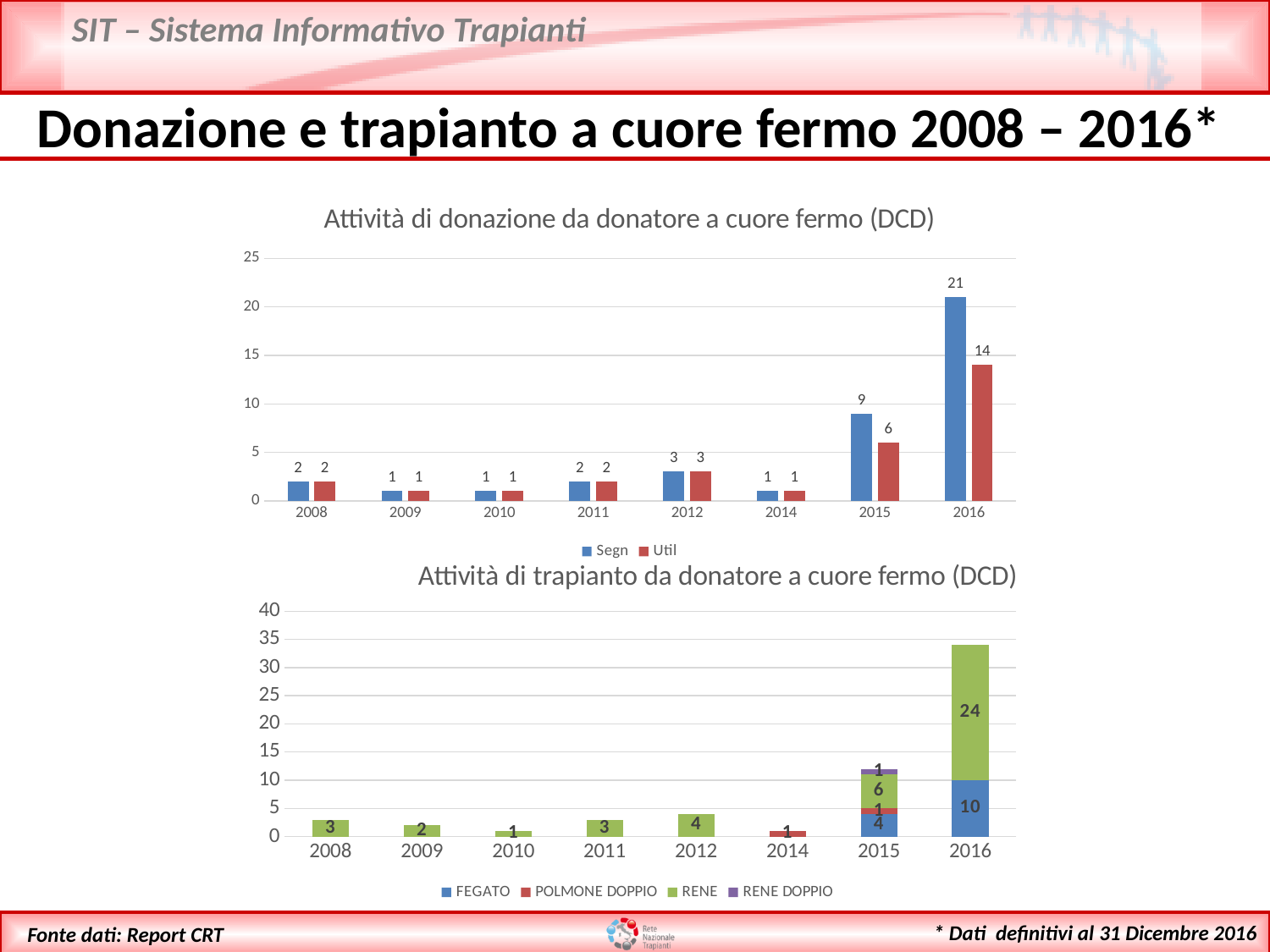
In the chart 'Attività di trapianto da donatore a cuore fermo (DCD)', what is the total of the stacked bar for 2016? 34 In the chart 'Attività di donazione da donatore a cuore fermo (DCD)', which year has the highest Segn value? 2016 In the chart 'Attività di donazione da donatore a cuore fermo (DCD)', what is the difference between the Segn and Util values for 2016? 7 What kind of chart is 'Attività di trapianto da donatore a cuore fermo (DCD)'? Stacked bar chart In the chart 'Attività di donazione da donatore a cuore fermo (DCD)', what is the Util value for 2015? 6 In the chart 'Attività di donazione da donatore a cuore fermo (DCD)', what is the Segn value for 2016? 21 In the chart 'Attività di donazione da donatore a cuore fermo (DCD)', how many years are shown on the x axis? 8 In the chart 'Attività di donazione da donatore a cuore fermo (DCD)', how many series does the legend list? 2 In the chart 'Attività di trapianto da donatore a cuore fermo (DCD)', what is the RENE value for 2016? 24 In the chart 'Attività di trapianto da donatore a cuore fermo (DCD)', what is the total of the stacked bar for 2015? 12 In the chart 'Attività di trapianto da donatore a cuore fermo (DCD)', what is the FEGATO value for 2015? 4 In the chart 'Attività di trapianto da donatore a cuore fermo (DCD)', how many series does the legend list? 4